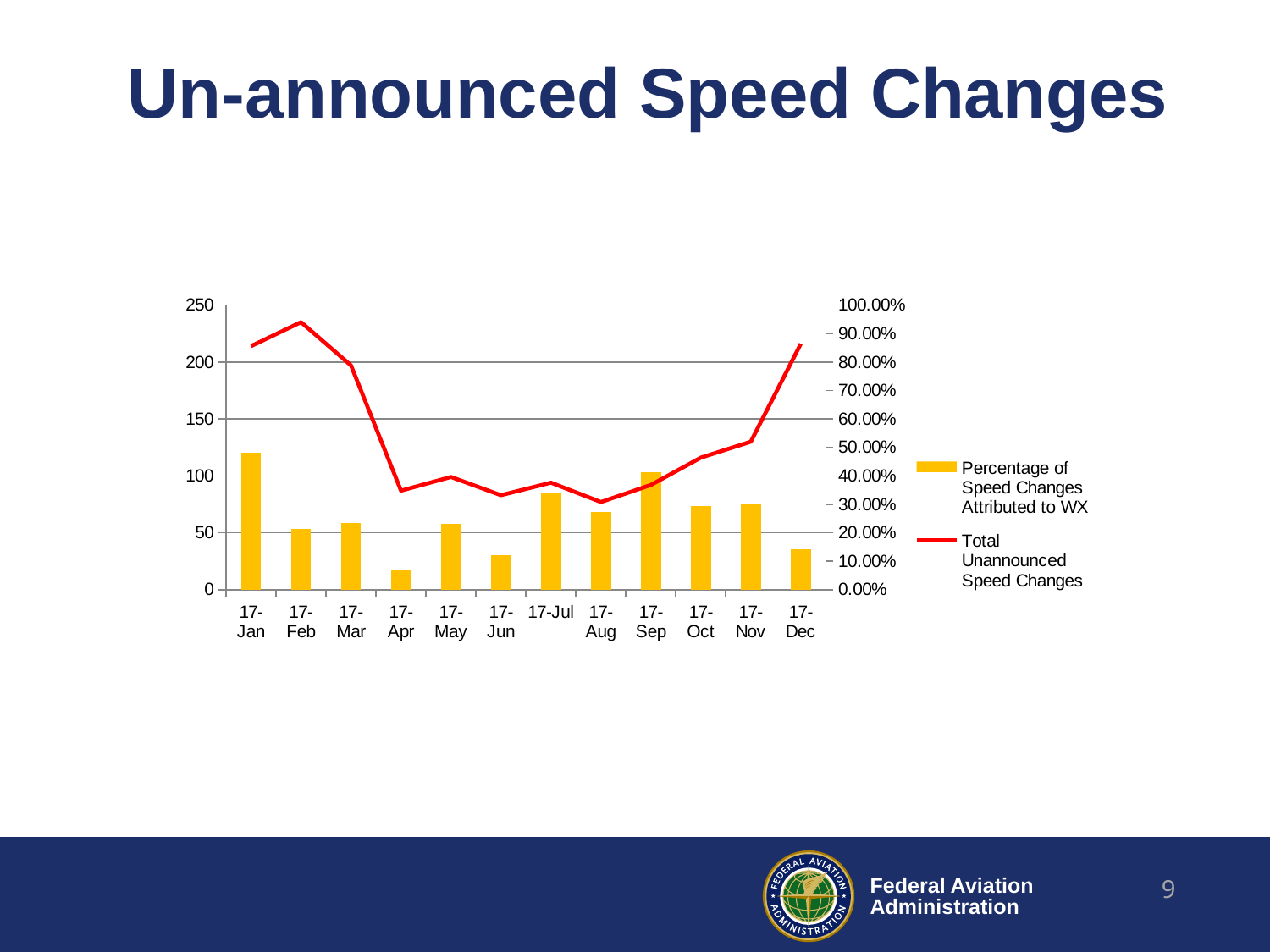
How many months are shown on the x axis of the chart? 12 Which month has the shortest yellow bar? 17-Apr In which month does the red Total Unannounced Speed Changes line reach its highest point? 17-Feb Does the red line rise or fall from 17-Sep to 17-Dec? Rises Is the red line's value for 17-Dec greater or less than 80.00% on the right axis? greater What colour is the line for Total Unannounced Speed Changes? Red How many series does the chart's legend list? 2 Does the red line rise or fall from 17-Feb to 17-Apr? Falls What type of chart is shown on the slide? Combination bar and line chart Which month has the taller yellow bar, 17-Jan or 17-Feb? 17-Jan Which month has the tallest yellow bar? 17-Jan Which month has the taller yellow bar, 17-Sep or 17-Oct? 17-Sep